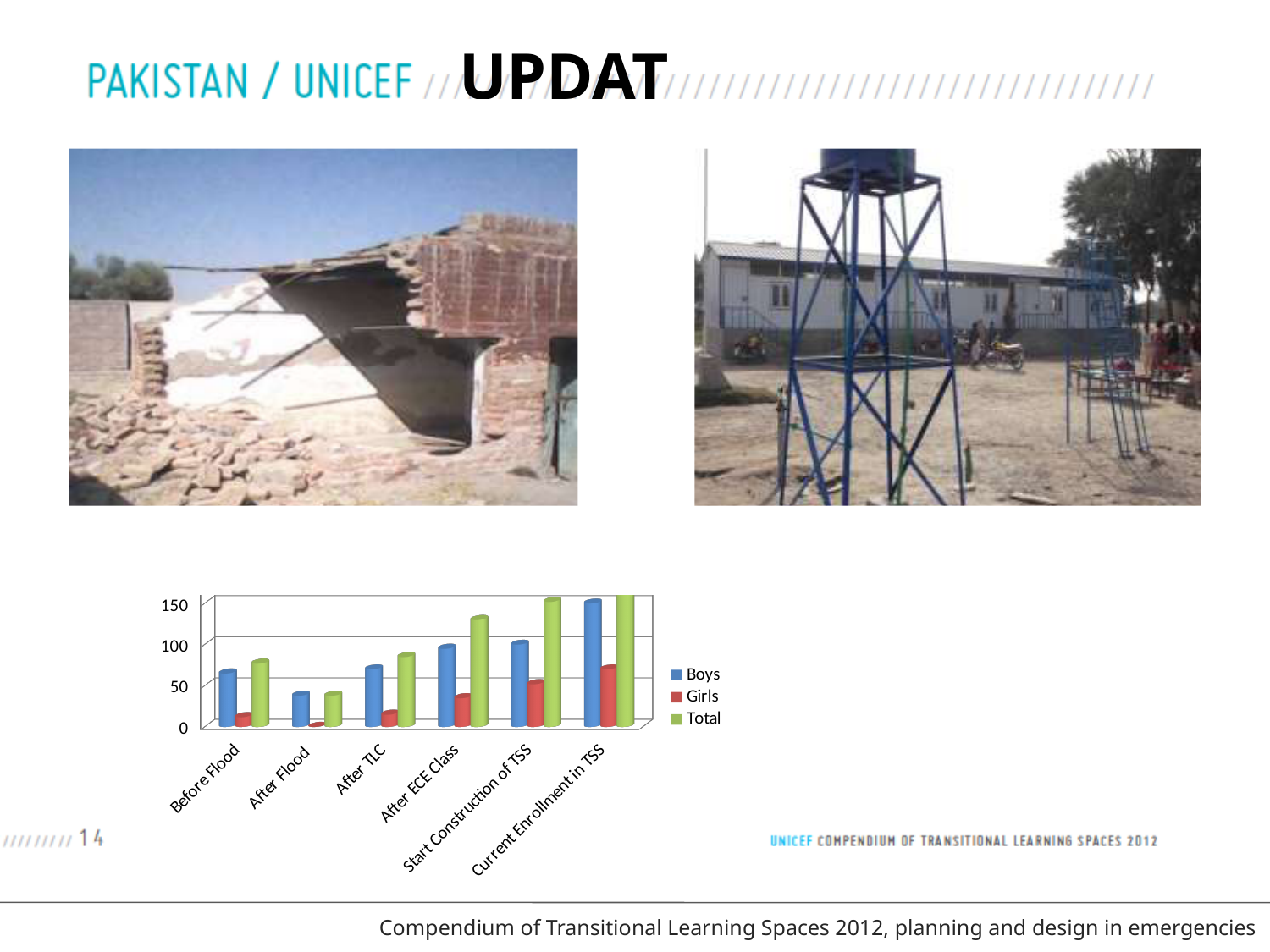
Which category has the lowest Boys value? After Flood Is the Boys value for Before Flood greater or less than 50? greater Which category has the highest Total value? Current Enrollment in TSS How many categories are shown along the x axis of the chart? 6 Is the Total value for After ECE Class greater or less than 100? greater Which category has the lowest Total value? After Flood For Current Enrollment in TSS, which is larger, the Boys value or the Girls value? Boys What kind of chart is shown on the slide? bar chart Is the Girls value for After Flood greater or less than 50? less What are the series names listed in the chart's legend? Boys, Girls, Total How many series does the chart's legend list? 3